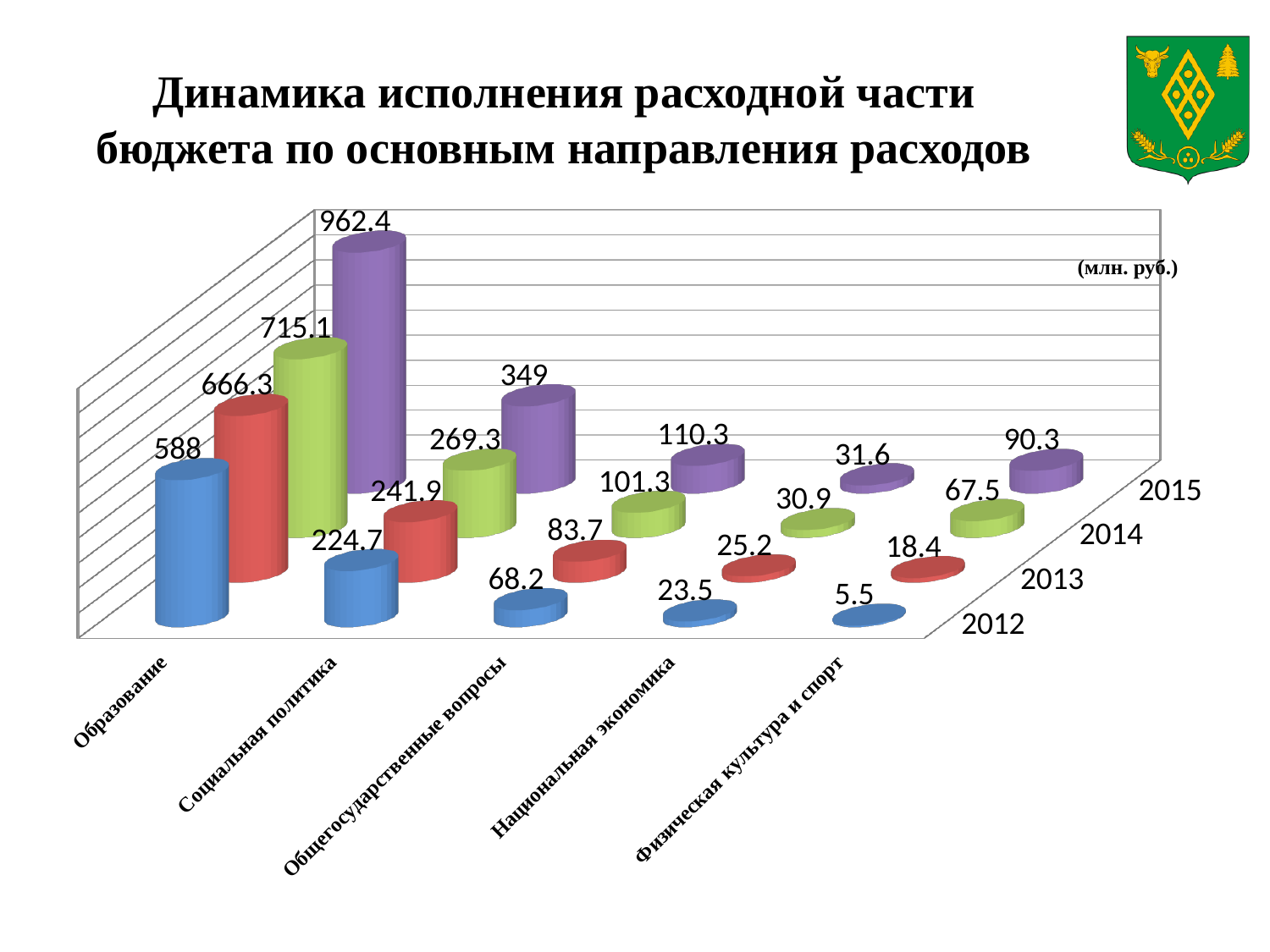
What is the difference between the Образование values for 2015 and 2012? 374.4 What kind of chart is shown on the slide? bar chart Do the values for Социальная политика rise or fall from 2012 to 2015? rise Which is larger: Национальная экономика in 2015 or Физическая культура и спорт in 2015? Физическая культура и спорт in 2015 Which category has the highest value in 2015? Образование Which category has the lowest value in 2012? Физическая культура и спорт How many years are shown on the chart? 4 What is the value for Социальная политика in 2012? 224.7 What is the value for Физическая культура и спорт in 2014? 67.5 How many expenditure categories are shown on the chart? 5 What is the value for Общегосударственные вопросы in 2013? 83.7 What is the value for Образование in 2015? 962.4